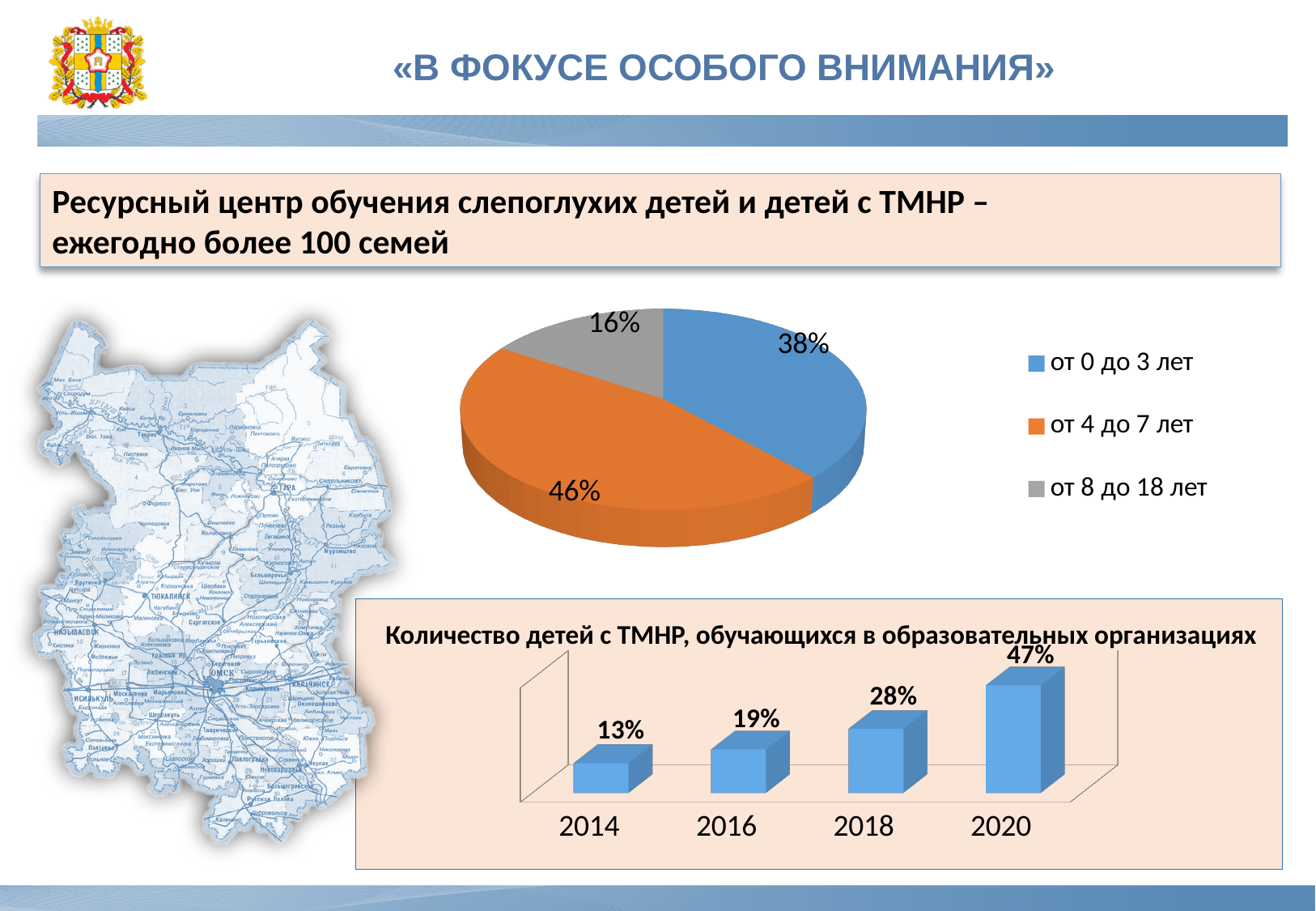
In the bar chart 'Количество детей с ТМНР, обучающихся в образовательных организациях', which year has the highest value? 2020 In the bar chart 'Количество детей с ТМНР, обучающихся в образовательных организациях', what is the difference between the values for 2020 and 2014? 34% In the pie chart, which age group has the largest share? от 4 до 7 лет In the bar chart 'Количество детей с ТМНР, обучающихся в образовательных организациях', what is the value for 2018? 28% In the pie chart, which age group has the smallest share? от 8 до 18 лет In the pie chart, what share is labelled for the 'от 4 до 7 лет' slice? 46% In the pie chart, which colour represents 'от 8 до 18 лет'? Grey In the pie chart, what is the difference between the shares for 'от 4 до 7 лет' and 'от 8 до 18 лет'? 30% In the pie chart, what share is labelled for the 'от 0 до 3 лет' slice? 38% In the bar chart 'Количество детей с ТМНР, обучающихся в образовательных организациях', do the values rise or fall from 2014 to 2020? Rise What kind of chart is the one at the bottom of the slide? Bar chart In the pie chart, how many slices are there? 3